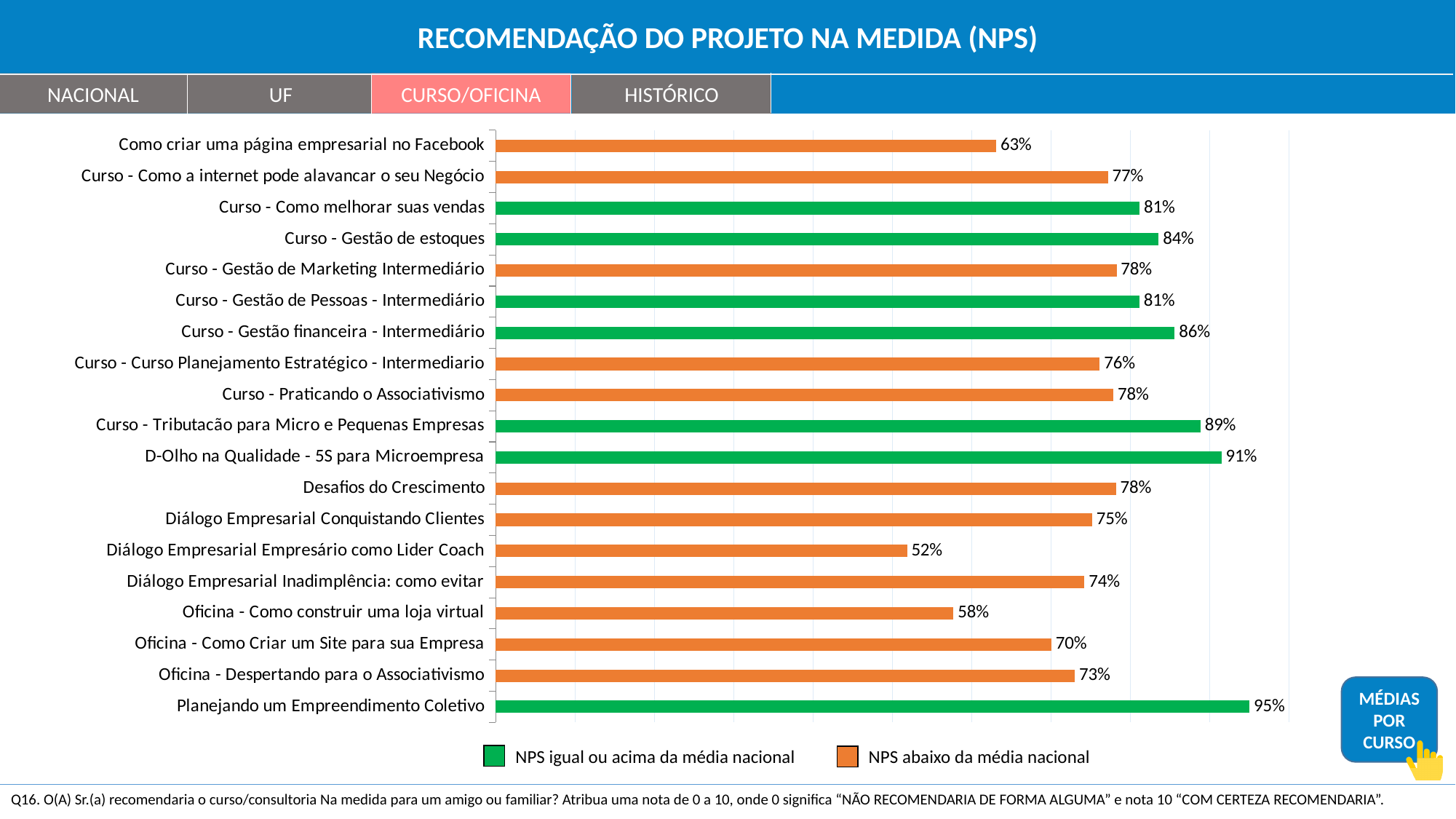
What is the NPS value for "Diálogo Empresarial Empresário como Lider Coach"? 52% What is the difference between the NPS of "D-Olho na Qualidade - 5S para Microempresa" and "Como criar uma página empresarial no Facebook"? 28% What type of chart is shown on the slide? Bar chart What is the NPS value for "Oficina - Como construir uma loja virtual"? 58% How many courses or workshops are shown in the chart? 19 Which has a higher NPS: "Curso - Tributação para Micro e Pequenas Empresas" or "Curso - Gestão financeira - Intermediário"? Curso - Tributação para Micro e Pequenas Empresas What is the NPS value for "Curso - Gestão de estoques"? 84% What is the NPS value for "Planejando um Empreendimento Coletivo"? 95% Which course or workshop has the highest NPS? Planejando um Empreendimento Coletivo What does the green colour in the legend represent? NPS igual ou acima da média nacional Which course or workshop has the lowest NPS? Diálogo Empresarial Empresário como Lider Coach How many entries does the legend list? 2